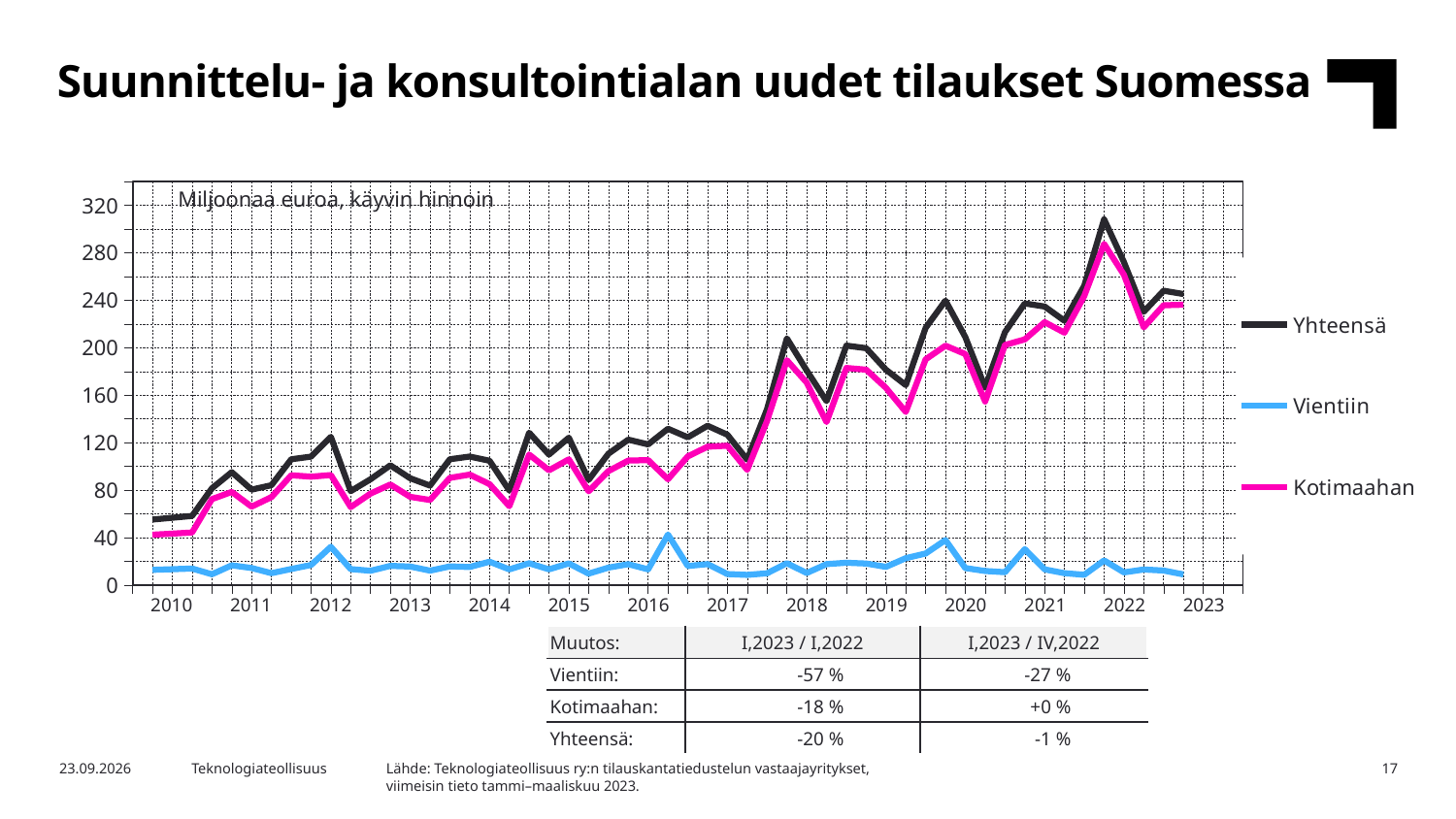
What kind of chart is shown on the slide? line chart Is the value for Vientiin at the start of 2010 greater or less than 40? less Which is larger in 2019, Kotimaahan or Vientiin? Kotimaahan Is the peak value of Kotimaahan in late 2021 greater or less than 240? greater Which series are listed in the legend? Yhteensä, Vientiin, Kotimaahan Which series has the highest values throughout the chart? Yhteensä How many series does the legend list? 3 Which series has the lowest values throughout the chart? Vientiin Does the Yhteensä series overall rise or fall from 2010 to 2023? rise Is the peak value of Yhteensä in late 2021 greater or less than 280? greater What unit is stated for the values in the chart? Miljoonaa euroa, käyvin hinnoin